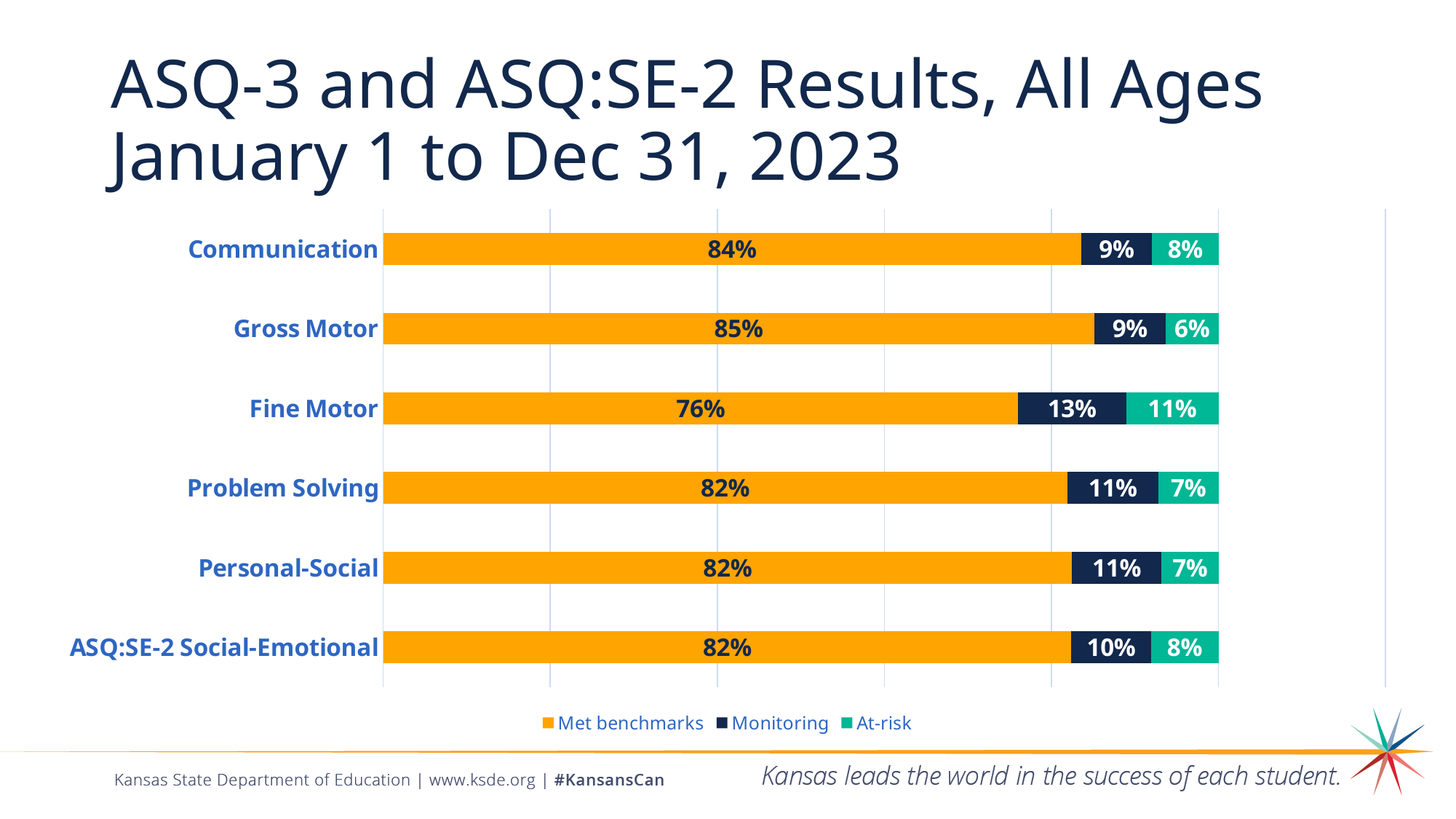
Which category has the highest At-risk percentage? Fine Motor What is the Monitoring value for Fine Motor? 13% What type of chart is shown on the slide? Stacked bar chart What is the difference in Met benchmarks percentage between Gross Motor and Fine Motor? 9 percentage points What is the total of the stacked bar for Fine Motor? 100% Which category has the highest Met benchmarks percentage? Gross Motor What percentage of Communication results met benchmarks? 84% Which category has the lowest Met benchmarks percentage? Fine Motor What is the At-risk value for ASQ:SE-2 Social-Emotional? 8% Which has a larger At-risk percentage, Communication or Gross Motor? Communication How many series does the legend list? 3 How many categories are shown on the chart? 6